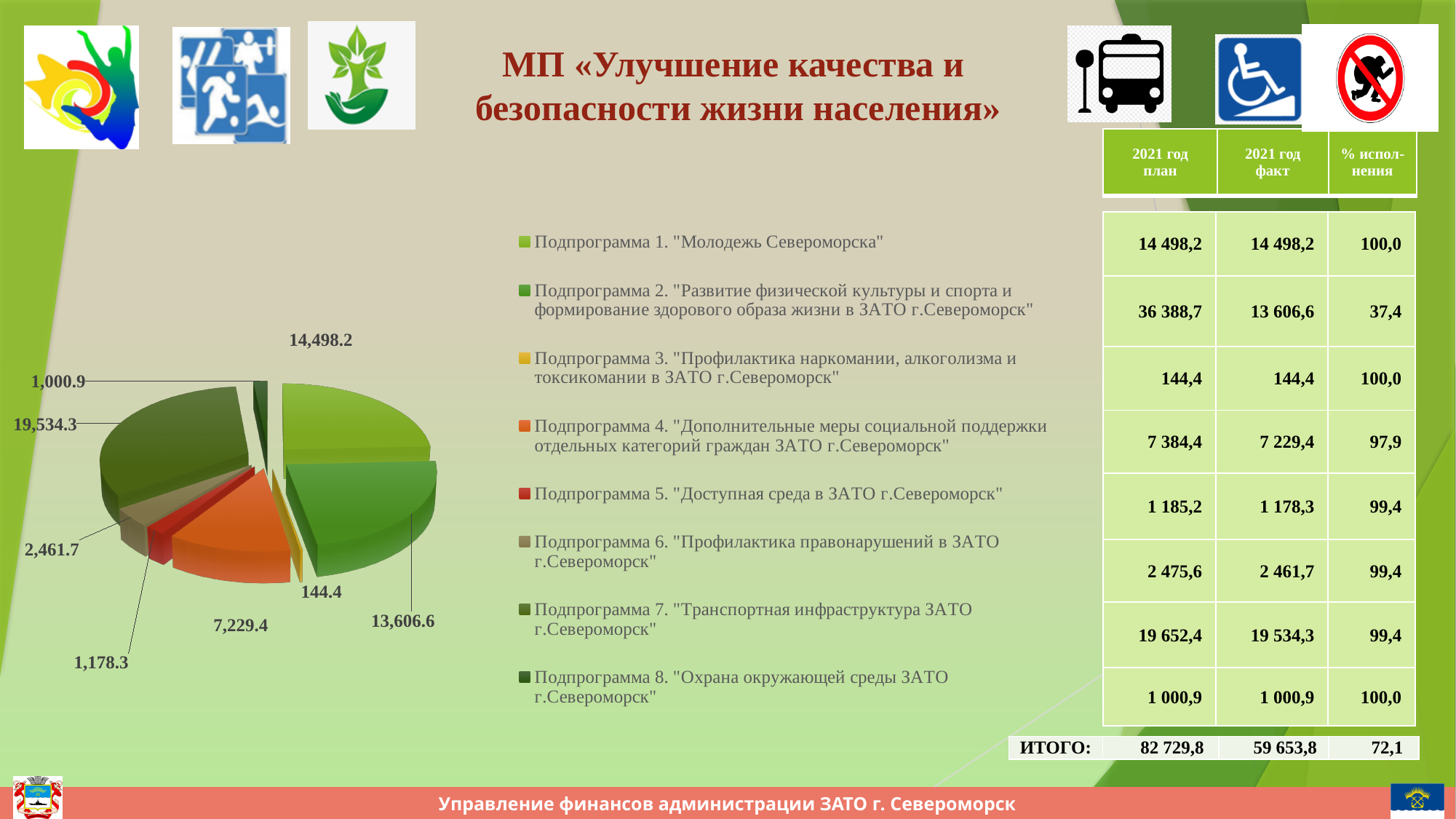
Which subprogram has the largest slice in the pie chart? Подпрограмма 7. "Транспортная инфраструктура ЗАТО г.Североморск" Which is larger in the pie chart: the value for Подпрограмма 1 or the value for Подпрограмма 2? Подпрограмма 1 How many slices does the pie chart have? 8 How many entries does the pie chart legend list? 8 What share of the pie chart total does Подпрограмма 7 (19,534.3) represent? 32.7% What value is shown on the pie chart for Подпрограмма 5. "Доступная среда в ЗАТО г.Североморск"? 1,178.3 What is the difference between the pie chart values for Подпрограмма 7 and Подпрограмма 1? 5,036.1 What value is shown on the pie chart for Подпрограмма 1. "Молодежь Североморска"? 14,498.2 What value is shown on the pie chart for Подпрограмма 4. "Дополнительные меры социальной поддержки отдельных категорий граждан ЗАТО г.Североморск"? 7,229.4 What kind of chart is shown on the slide? pie chart Which subprogram has the smallest slice in the pie chart? Подпрограмма 3. "Профилактика наркомании, алкоголизма и токсикомании в ЗАТО г.Североморск" What value is shown on the pie chart for Подпрограмма 7. "Транспортная инфраструктура ЗАТО г.Североморск"? 19,534.3